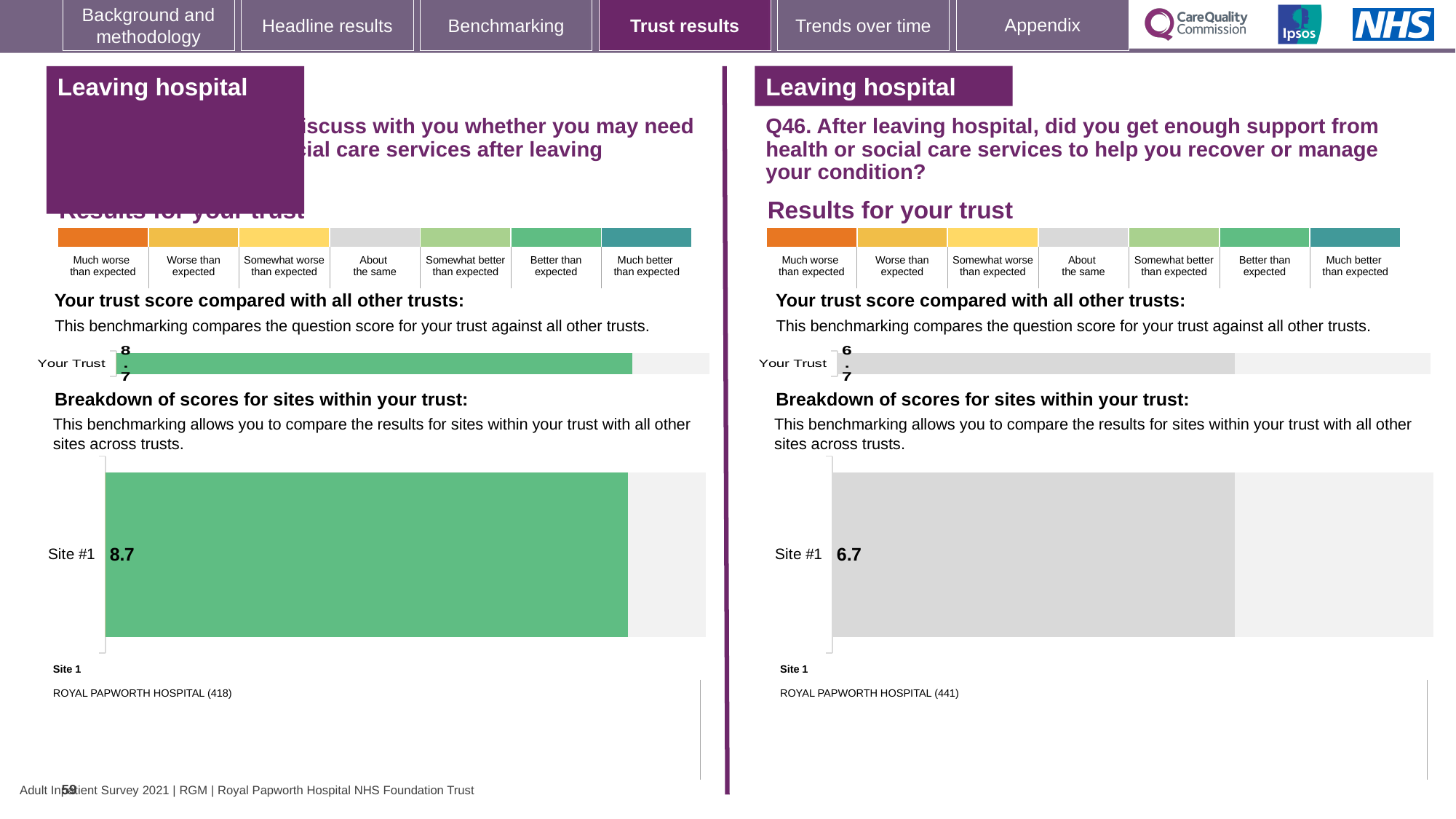
On the left-hand side of the slide, which site name is listed as Site 1? ROYAL PAPWORTH HOSPITAL (418) On the right-hand side of the slide (Q46), which site name is listed as Site 1? ROYAL PAPWORTH HOSPITAL (441) On the left-hand side of the slide, what is the score shown for Site #1? 8.7 How many sites are shown in the 'Breakdown of scores for sites within your trust' chart on the right-hand side of the slide (Q46)? 1 What is the difference between the Site #1 score on the left-hand side of the slide and the Site #1 score on the right-hand side (Q46)? 2.0 On the right-hand side of the slide (Q46), what is the score shown for Site #1? 6.7 What type of chart is used to show the Site #1 score on the right-hand side of the slide (Q46)? Bar chart Is the Your Trust score on the right-hand side of the slide (Q46) greater or less than the Your Trust score on the left-hand side? less Which is larger: the Site #1 score on the left-hand side of the slide or the Site #1 score on the right-hand side (Q46)? Left-hand side (8.7) On the left-hand side of the slide, what is the score shown for Your Trust? 8.7 On the right-hand side of the slide (Q46), what is the score shown for Your Trust? 6.7